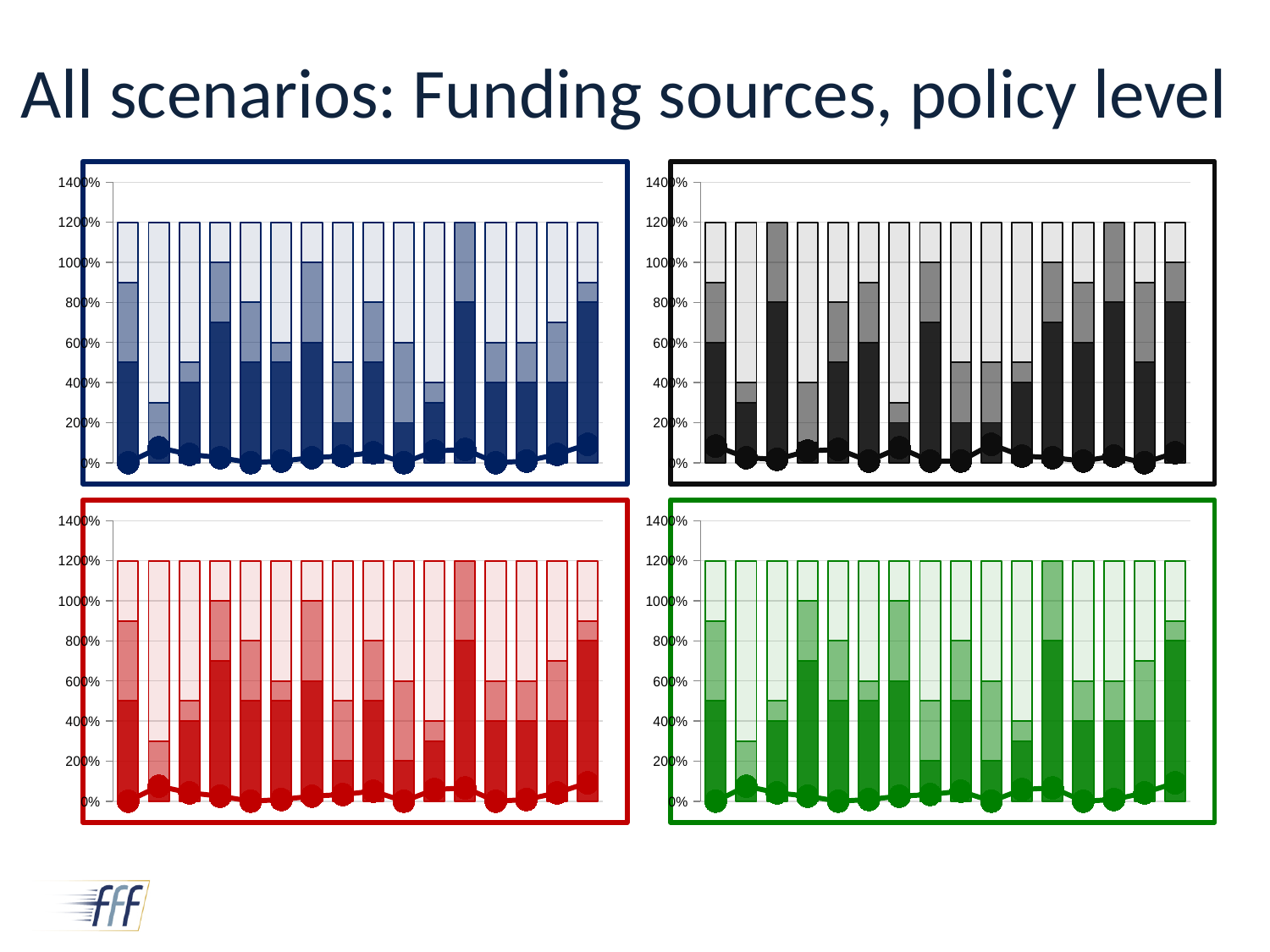
What colour is used for the bars in the bottom-left chart? Red What is the title of the slide containing the four charts? All scenarios: Funding sources, policy level What kind of chart is the top-left chart on the slide? Stacked bar chart with a line How many bars does the top-left (blue) chart contain? 16 In the top-right (black) chart, does the line series run near the top or near the bottom of the plot area? Near the bottom How many bars does the bottom-right (green) chart contain? 16 How many charts are shown on the slide? 4